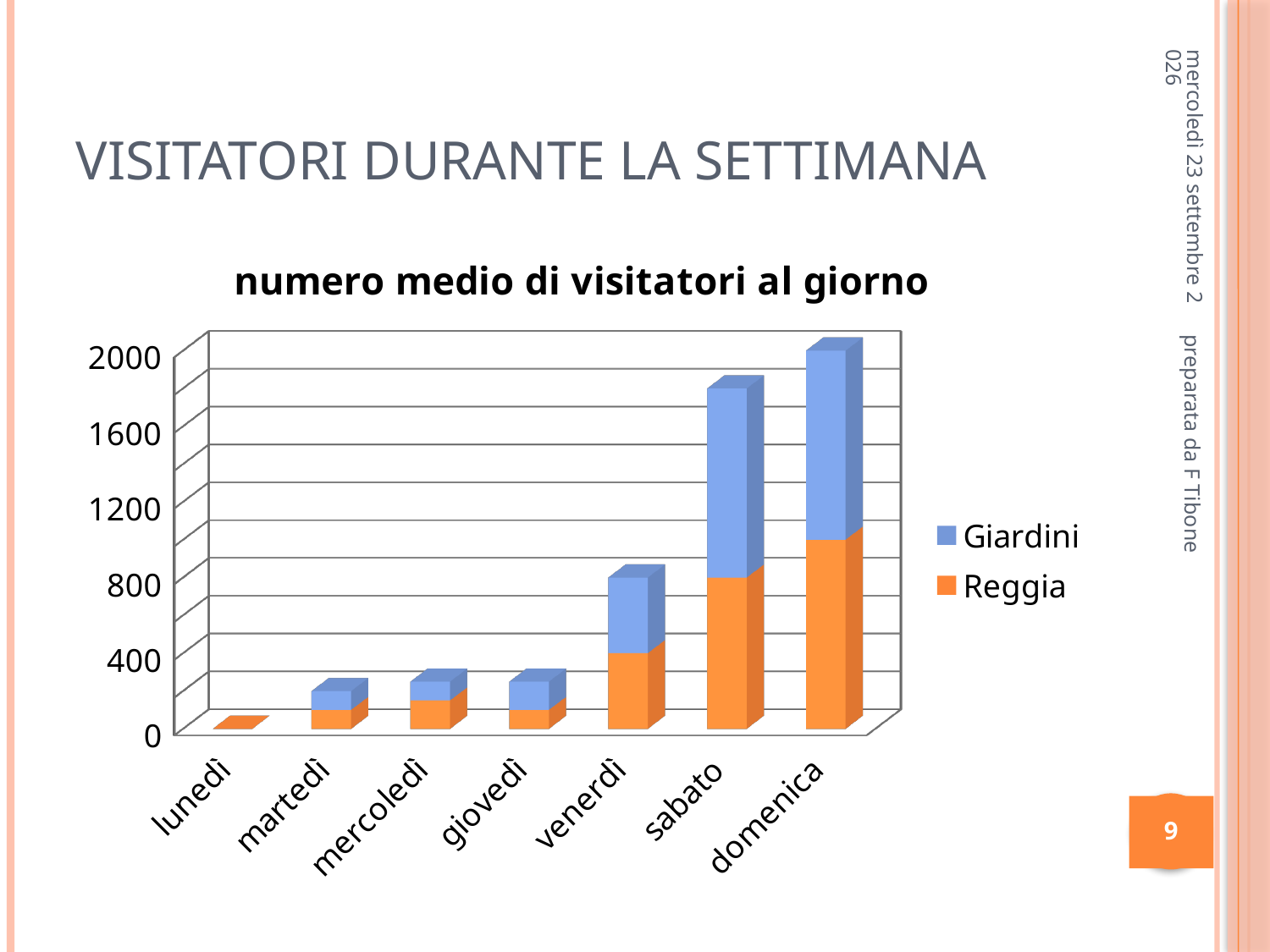
Which day has the highest total number of visitors? domenica Which colour represents the Reggia series in the legend? orange Which day has the lowest total number of visitors? lunedì What is the title of the chart? numero medio di visitatori al giorno Which day has more total visitors, sabato or venerdì? sabato How many days (categories) are shown on the x axis? 7 Is the total value for domenica greater or less than 1600? greater Is the total value for martedì greater or less than 400? less How many series does the legend list? 2 What kind of chart is shown on the slide? Stacked bar chart Do the total visitor numbers generally rise or fall from lunedì to domenica? rise Is the total value for venerdì greater or less than 1200? less